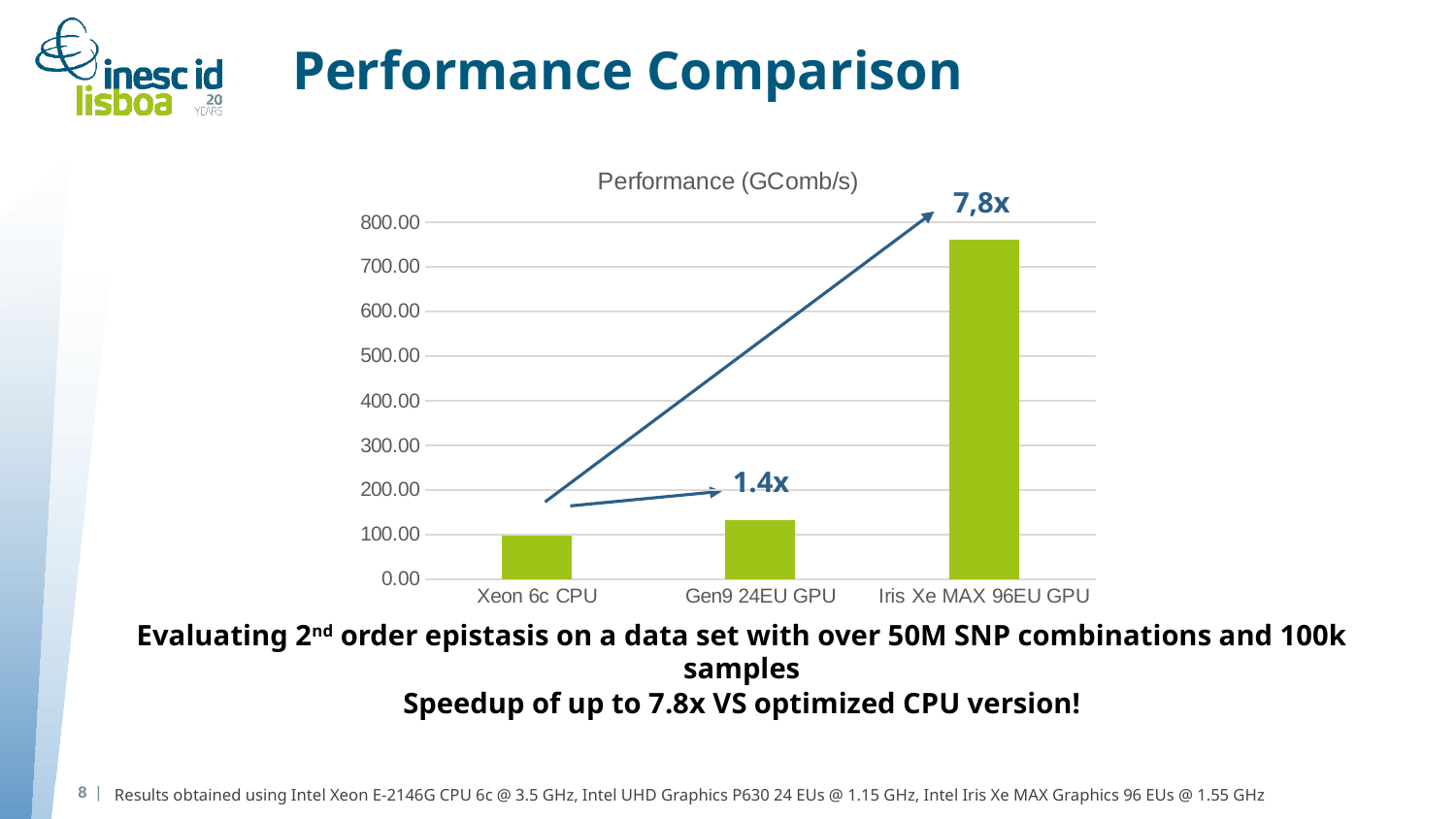
What speedup is annotated on the chart for the Iris Xe MAX 96EU GPU? 7,8x Which category has the highest performance in the chart? Iris Xe MAX 96EU GPU Which has the larger value, Gen9 24EU GPU or Xeon 6c CPU? Gen9 24EU GPU Is the value for Xeon 6c CPU greater or less than 200.00? less What is the highest value shown on the y axis of the chart? 800.00 How many categories are plotted on the x axis of the chart? 3 Which category has the lowest performance in the chart? Xeon 6c CPU Is the value for Iris Xe MAX 96EU GPU greater or less than 700.00? greater Do the values rise or fall from left to right along the x axis? rise What is the title of the chart? Performance (GComb/s) What kind of chart is shown on the slide? bar chart Is the value for Gen9 24EU GPU greater or less than 100.00? greater